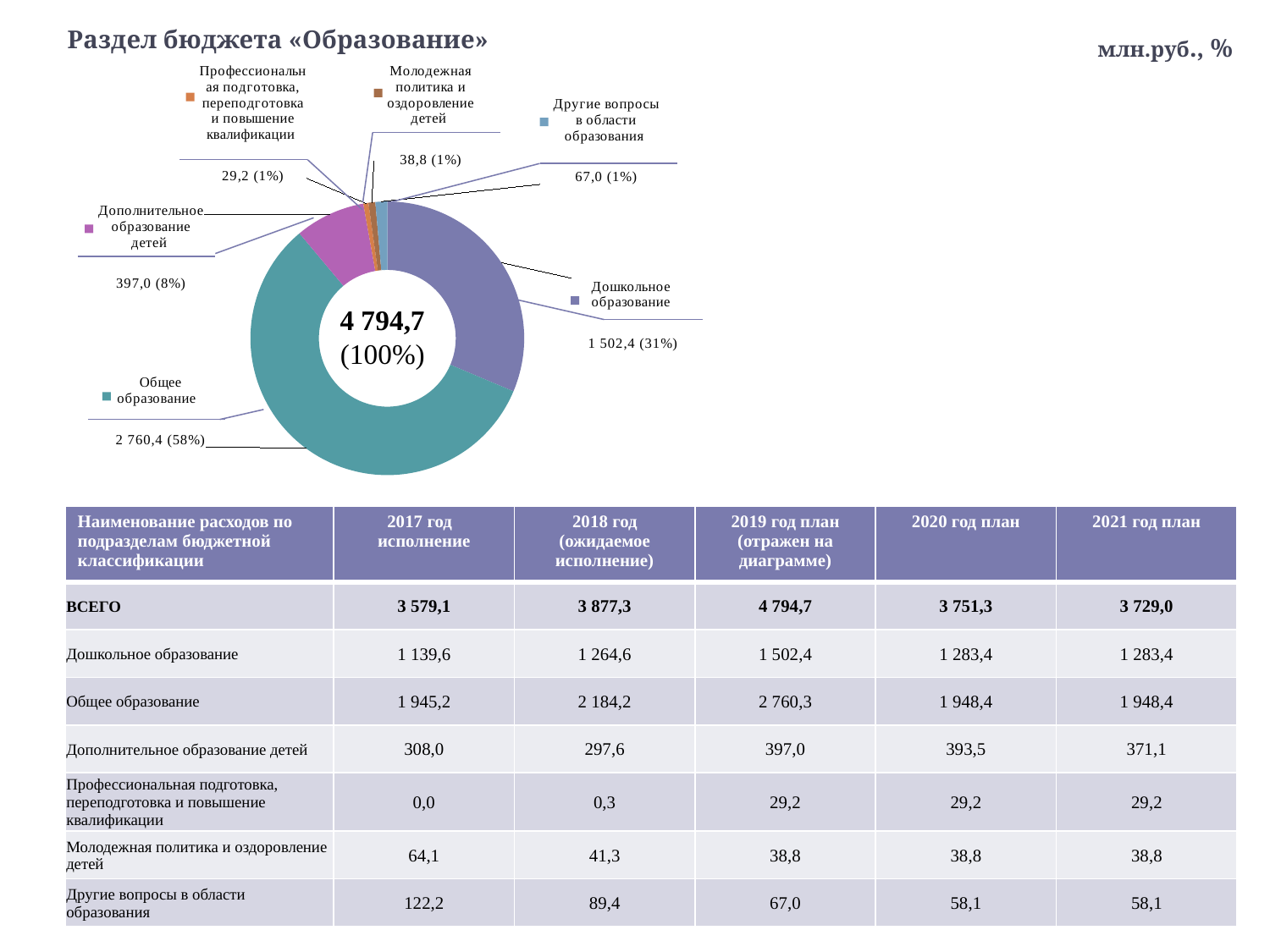
What is the value shown for «Дошкольное образование» on the chart? 1 502,4 (31%) What kind of chart is shown on the slide? pie chart (donut) Which category has the smallest slice of the pie? Профессиональная подготовка, переподготовка и повышение квалификации Which is larger on the chart: «Молодежная политика и оздоровление детей» or «Профессиональная подготовка, переподготовка и повышение квалификации»? Молодежная политика и оздоровление детей What is the value shown for «Дополнительное образование детей» on the chart? 397,0 (8%) What is the value shown for «Другие вопросы в области образования» on the chart? 67,0 (1%) How many categories does the pie chart show? 6 What is the difference between the values for «Общее образование» and «Дошкольное образование» on the chart? 1 258,0 What share of the pie does «Общее образование» take? 58% Which category has the largest slice of the pie? Общее образование What is the value shown for «Общее образование» on the chart? 2 760,4 (58%) What total value is printed in the centre of the donut chart? 4 794,7 (100%)